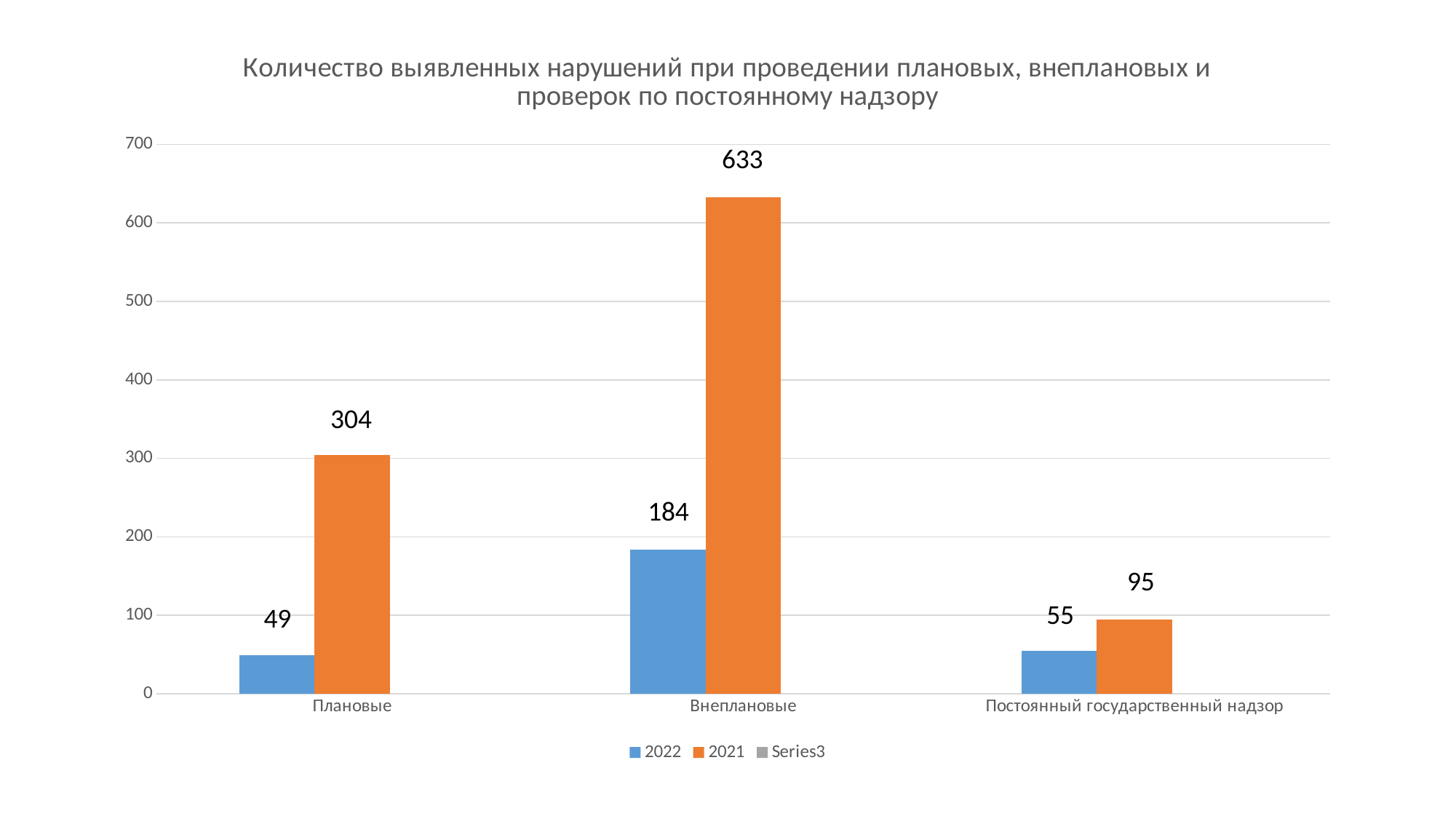
Which category has the lowest value for 2022? Плановые How many series does the legend list? 3 Which category has the highest value for 2021? Внеплановые What is the value for 2022 in the Плановые category? 49 What kind of chart is shown on the slide? Bar chart What is the value for 2021 in the Внеплановые category? 633 What is the value for 2022 in the Постоянный государственный надзор category? 55 How many categories are shown on the x axis? 3 What is the value for 2021 in the Плановые category? 304 What is the difference between the 2021 and 2022 values in the Внеплановые category? 449 Which is larger in the Постоянный государственный надзор category: the 2022 value or the 2021 value? 2021 What colour are the bars for the 2021 series? Orange